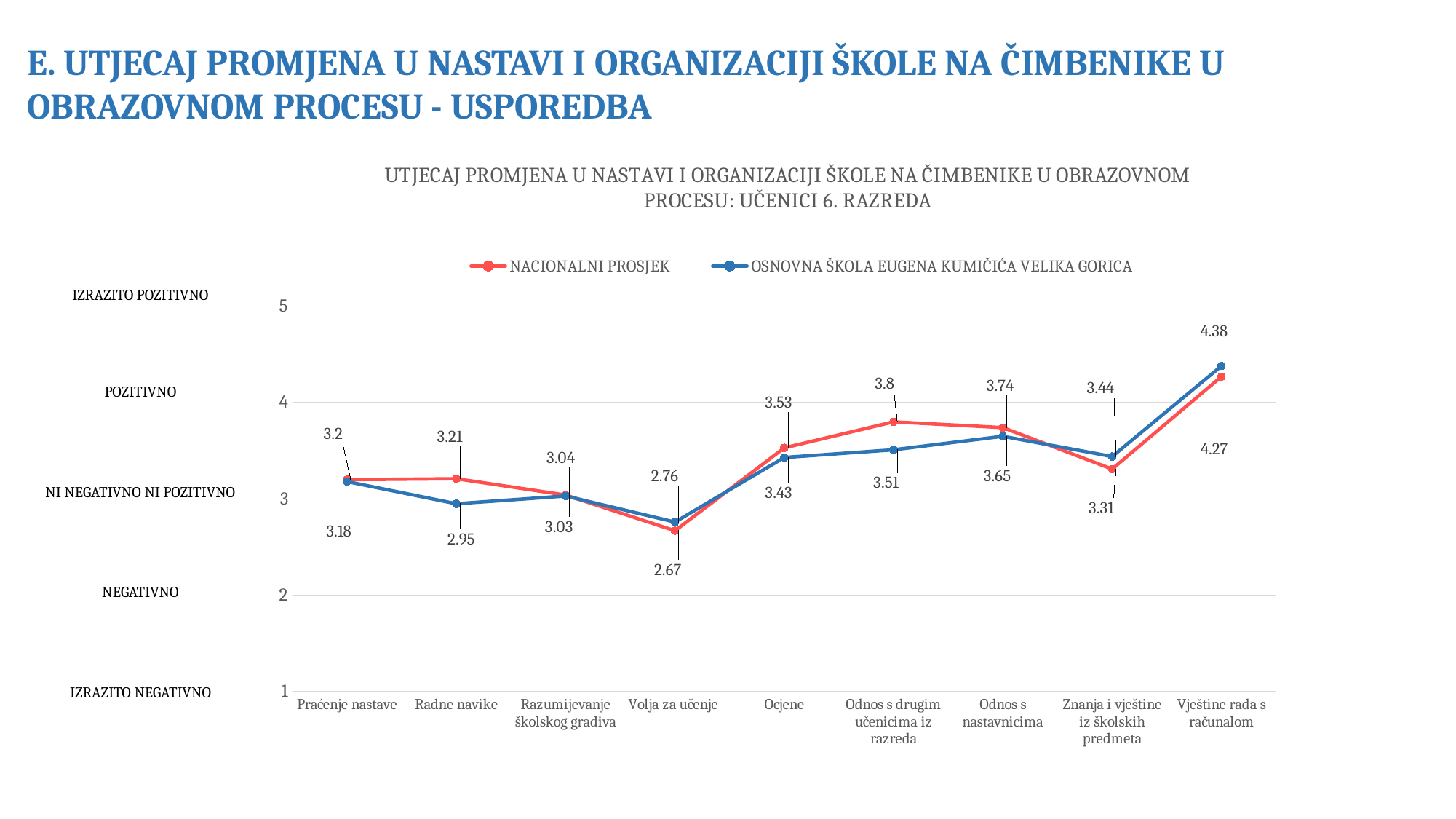
Which category has the highest value for OSNOVNA ŠKOLA EUGENA KUMIČIĆA VELIKA GORICA? Vještine rada s računalom Is the NACIONALNI PROSJEK value for Vještine rada s računalom greater or less than 4? greater For Znanja i vještine iz školskih predmeta, which series has the larger value? OSNOVNA ŠKOLA EUGENA KUMIČIĆA VELIKA GORICA What is the value for OSNOVNA ŠKOLA EUGENA KUMIČIĆA VELIKA GORICA for Radne navike? 2.95 How many series does the legend list? 2 Which colour is used for the NACIONALNI PROSJEK series? red How many categories are shown on the x axis? 9 What is the NACIONALNI PROSJEK value for Ocjene? 3.53 What is the difference between the NACIONALNI PROSJEK and OSNOVNA ŠKOLA EUGENA KUMIČIĆA VELIKA GORICA values for Odnos s drugim učenicima iz razreda? 0.29 What is the NACIONALNI PROSJEK value for Volja za učenje? 2.67 What kind of chart is shown on the slide? line chart Which category has the lowest value for NACIONALNI PROSJEK? Volja za učenje